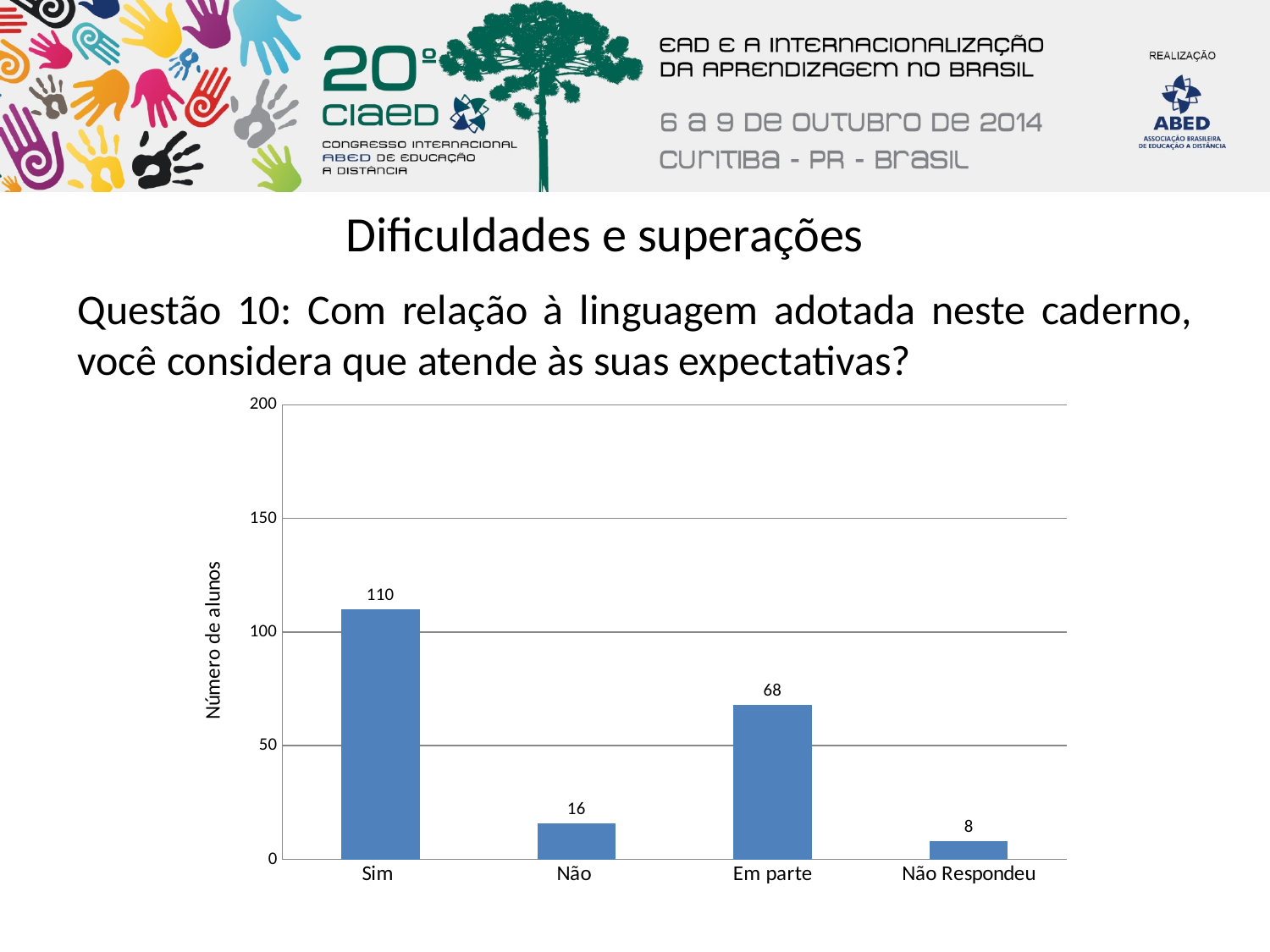
What is the label of the vertical axis? Número de alunos How many categories are shown on the x axis? 4 Is the value for Sim greater or less than 100? greater What is the value for Não? 16 What kind of chart is shown on the slide? bar chart Which category has the lowest value? Não Respondeu What is the value for Não Respondeu? 8 What is the value for Sim? 110 Which is larger, the value for Não or the value for Em parte? Em parte What is the value for Em parte? 68 Which category has the highest value? Sim What is the difference between the values for Sim and Em parte? 42